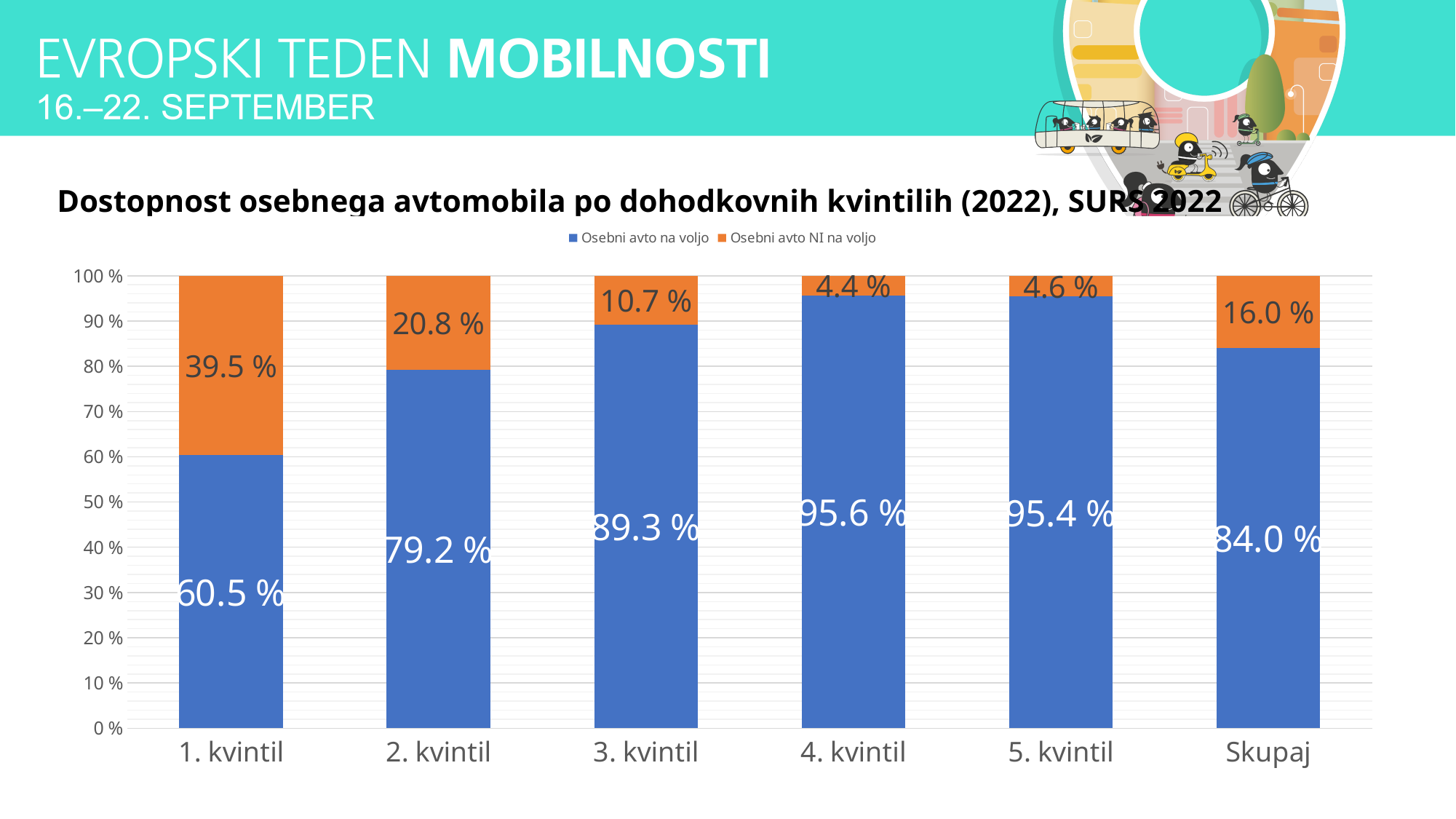
What colour represents "Osebni avto NI na voljo" in the chart? Orange Which is larger: the "Osebni avto NI na voljo" value for 3. kvintil or for Skupaj? Skupaj What is the value of "Osebni avto na voljo" for Skupaj? 84.0 % What is the difference between the "Osebni avto na voljo" values for 3. kvintil and 2. kvintil? 10.1 % What is the value of "Osebni avto na voljo" for 1. kvintil? 60.5 % Which category has the highest value for "Osebni avto NI na voljo"? 1. kvintil What is the total of the stacked bar for 4. kvintil? 100 % What kind of chart is shown on the slide? Stacked bar chart What is the value of "Osebni avto NI na voljo" for 2. kvintil? 20.8 % Which category has the lowest value for "Osebni avto na voljo"? 1. kvintil How many categories are shown on the x axis? 6 How many series does the legend list? 2